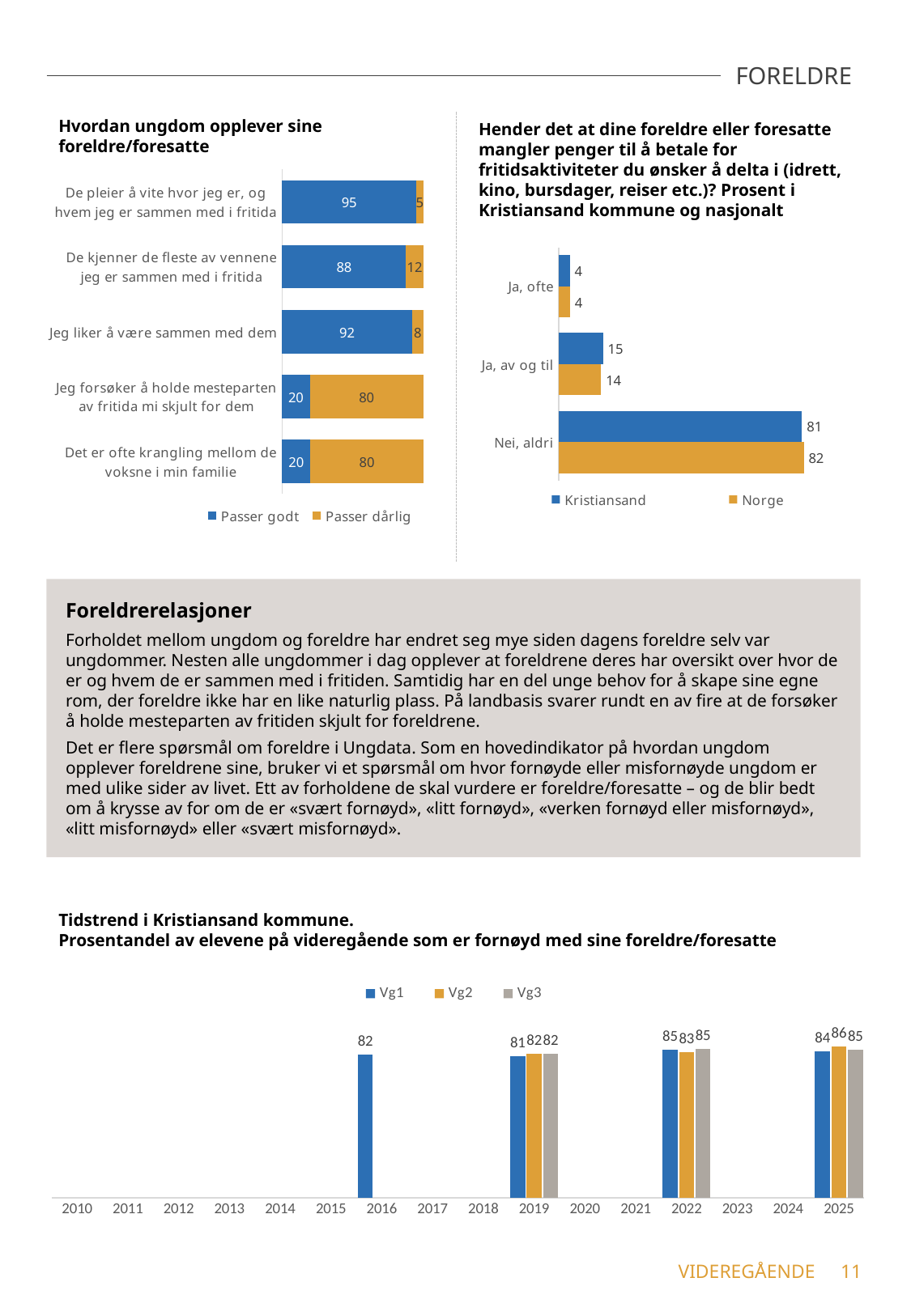
In the chart 'Hvordan ungdom opplever sine foreldre/foresatte', what is the total of the stacked bar for 'Jeg liker å være sammen med dem'? 100 In the chart 'Hvordan ungdom opplever sine foreldre/foresatte', how many statements (categories) are shown? 5 In the chart 'Hender det at dine foreldre eller foresatte mangler penger...', what is the Kristiansand value for 'Ja, av og til'? 15 In the chart 'Tidstrend i Kristiansand kommune', what is the difference between the Vg1 values for 2022 and 2019? 4 What kind of chart is 'Tidstrend i Kristiansand kommune'? Bar chart In the chart 'Hender det at dine foreldre eller foresatte mangler penger...', what is the difference between the Kristiansand and Norge values for 'Ja, av og til'? 1 In the chart 'Hender det at dine foreldre eller foresatte mangler penger...', how many series does the legend list? 2 In the chart 'Tidstrend i Kristiansand kommune', what is the Vg2 value for 2025? 86 In the chart 'Hender det at dine foreldre eller foresatte mangler penger...', what is the Norge value for 'Nei, aldri'? 82 In the chart 'Hvordan ungdom opplever sine foreldre/foresatte', what is the 'Passer dårlig' value for 'De kjenner de fleste av vennene jeg er sammen med i fritida'? 12 In the chart 'Hvordan ungdom opplever sine foreldre/foresatte', what is the 'Passer godt' value for 'De pleier å vite hvor jeg er, og hvem jeg er sammen med i fritida'? 95 In the chart 'Hvordan ungdom opplever sine foreldre/foresatte', which statement has the highest 'Passer godt' value? De pleier å vite hvor jeg er, og hvem jeg er sammen med i fritida